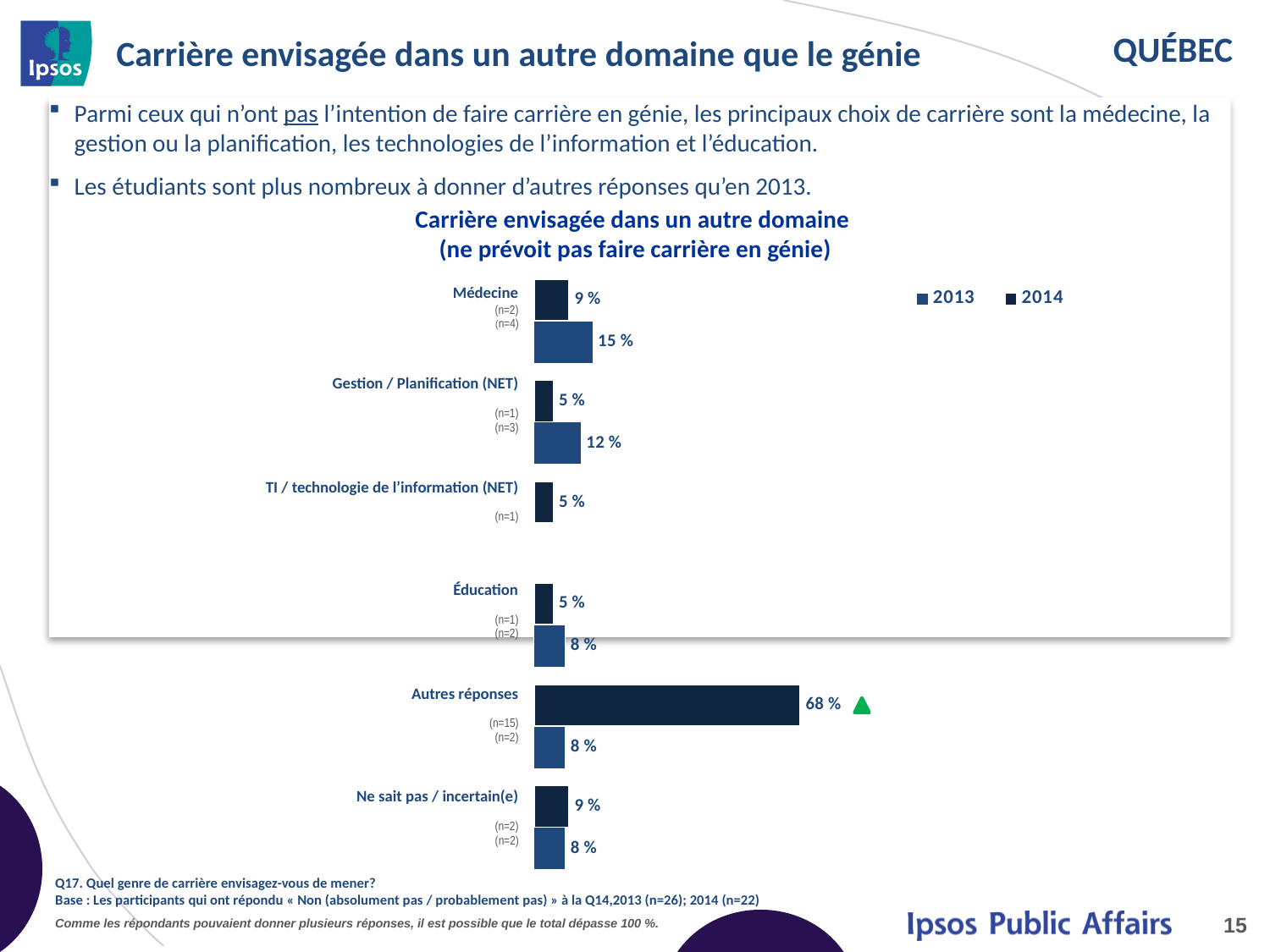
What is the title of the chart? Carrière envisagée dans un autre domaine (ne prévoit pas faire carrière en génie) What type of chart is shown on the slide? bar chart What is the 2014 value for Médecine? 9 % Which category has the highest 2014 value? Autres réponses What is the 2014 value for Gestion / Planification (NET)? 5 % How many series does the chart legend list? 2 What is the 2013 value for Ne sait pas / incertain(e)? 8 % What is the difference between the 2013 and 2014 values for Autres réponses? 60 % Which category has the highest 2013 value? Médecine Which is larger for Gestion / Planification (NET): the 2013 value or the 2014 value? 2013 How many categories are shown in the chart? 6 What is the 2013 value for Autres réponses? 8 %